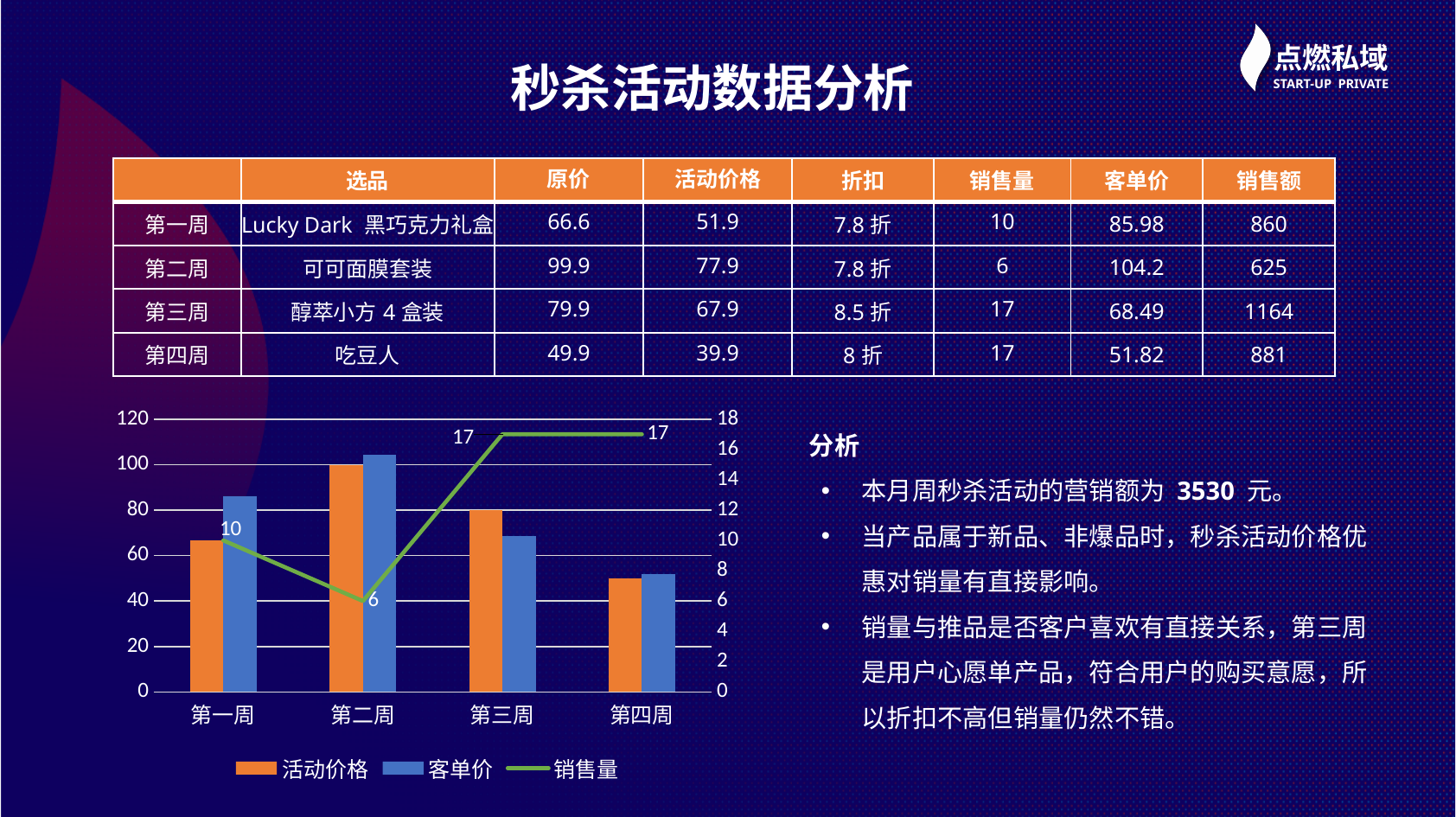
What is the 销售量 value for 第三周 in the chart? 17 Is the 客单价 bar for 第四周 greater or less than 60? less What kind of chart is shown on the slide? Combination bar and line chart Which week has the lowest 销售量 in the chart? 第二周 For 第一周, which bar is taller: 活动价格 or 客单价? 客单价 What colour is the 销售量 line in the chart? Green What is the difference in 销售量 between 第三周 and 第二周? 11 What is the 销售量 value for 第二周 in the chart? 6 Is the 活动价格 bar for 第二周 greater or less than 80? greater How many series does the chart legend list? 3 How many weeks (categories) are shown on the x axis of the chart? 4 For 第三周, which bar is taller: 活动价格 or 客单价? 活动价格